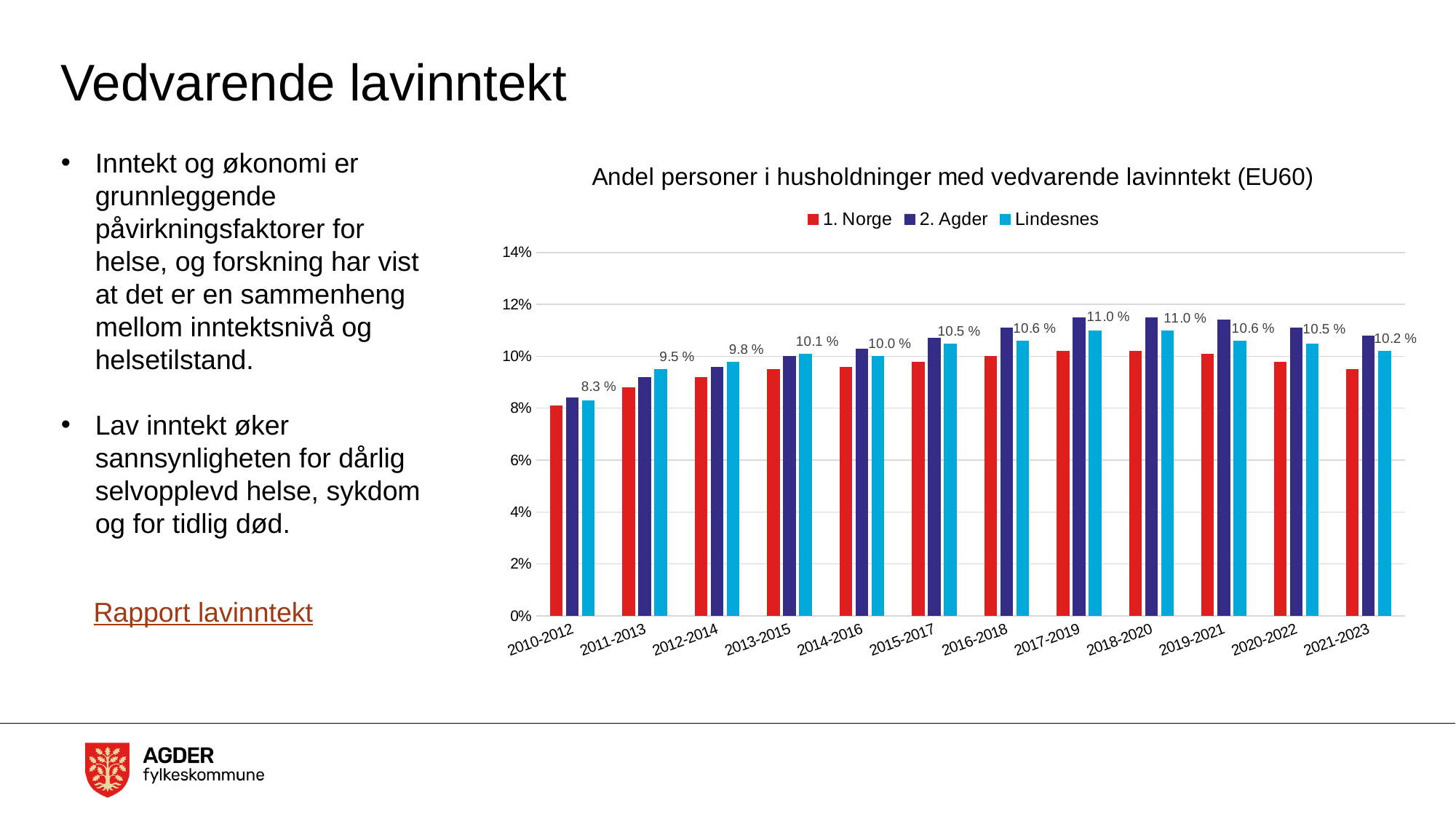
What is the value for Lindesnes in 2010-2012? 8.3 % In which period is the Lindesnes value lowest? 2010-2012 From 2010-2012 to 2017-2019, do the Lindesnes values rise or fall? rise What is the value for Lindesnes in 2017-2019? 11.0 % What is the value for Lindesnes in 2021-2023? 10.2 % What is the title of the chart? Andel personer i husholdninger med vedvarende lavinntekt (EU60) Which is larger for Lindesnes: the value in 2011-2013 or in 2012-2014? 2012-2014 How many series does the legend list? 3 What type of chart is shown on the slide? bar chart What is the difference between the Lindesnes values for 2011-2013 and 2010-2012? 1.2 % How many periods are shown on the x axis? 12 Is the value for 2. Agder in 2018-2020 greater or less than 12%? less